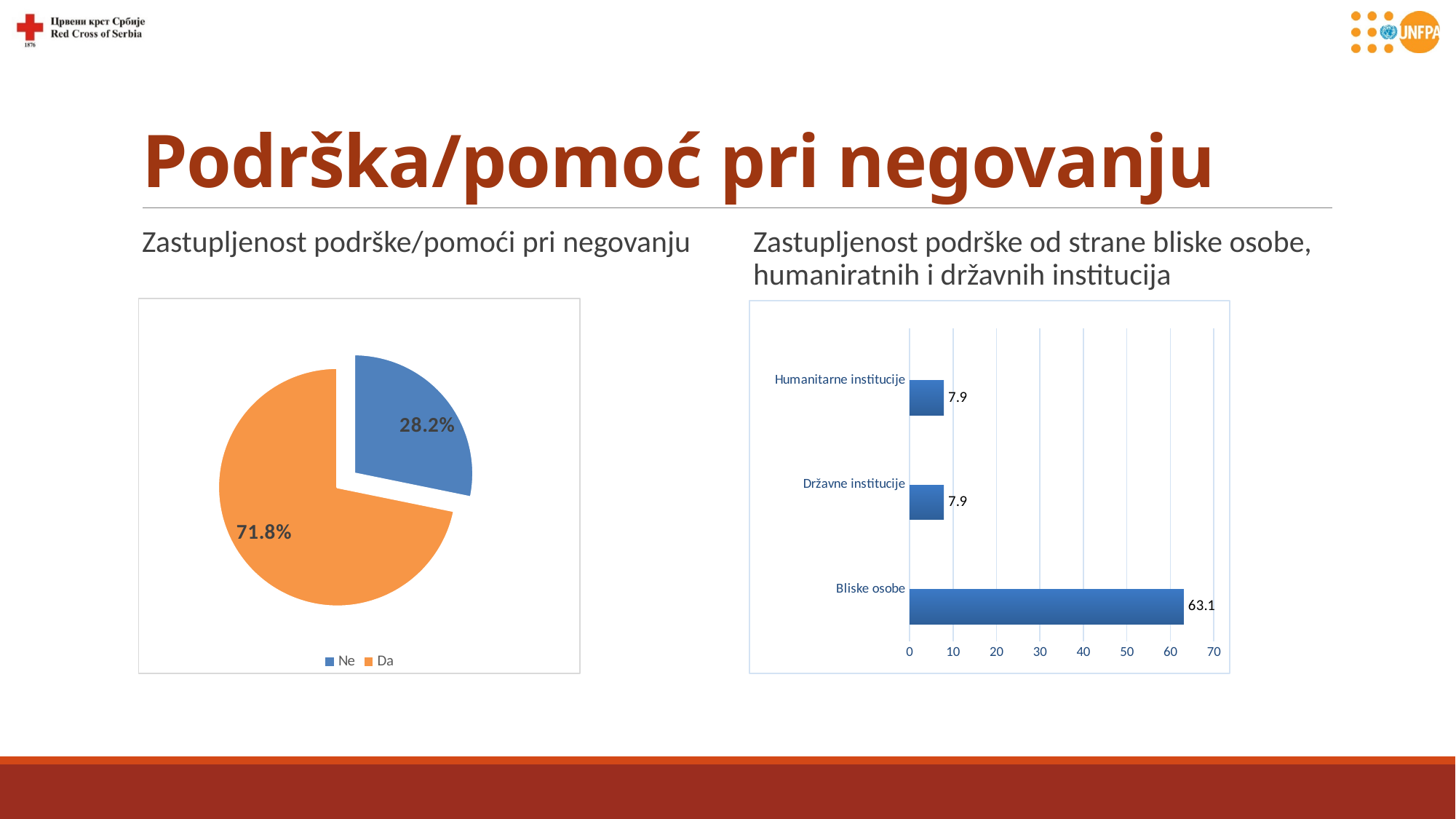
In the bar chart on the right, what is the value for 'Humanitarne institucije'? 7.9 In the pie chart on the left, what share is labelled for 'Da'? 71.8% In the bar chart on the right, how many categories are shown? 3 In the pie chart on the left, what share is labelled for 'Ne'? 28.2% What kind of chart is the chart on the left? pie chart In the bar chart on the right, what is the difference between 'Bliske osobe' and 'Državne institucije'? 55.2 In the bar chart on the right, which category has the highest value? Bliske osobe In the pie chart on the left, which slice is larger, 'Da' or 'Ne'? Da In the bar chart on the right, what is the value for 'Bliske osobe'? 63.1 In the pie chart on the left, what is the difference between the 'Da' and 'Ne' shares? 43.6% What kind of chart is the chart on the right? bar chart How many entries does the legend of the pie chart on the left list? 2